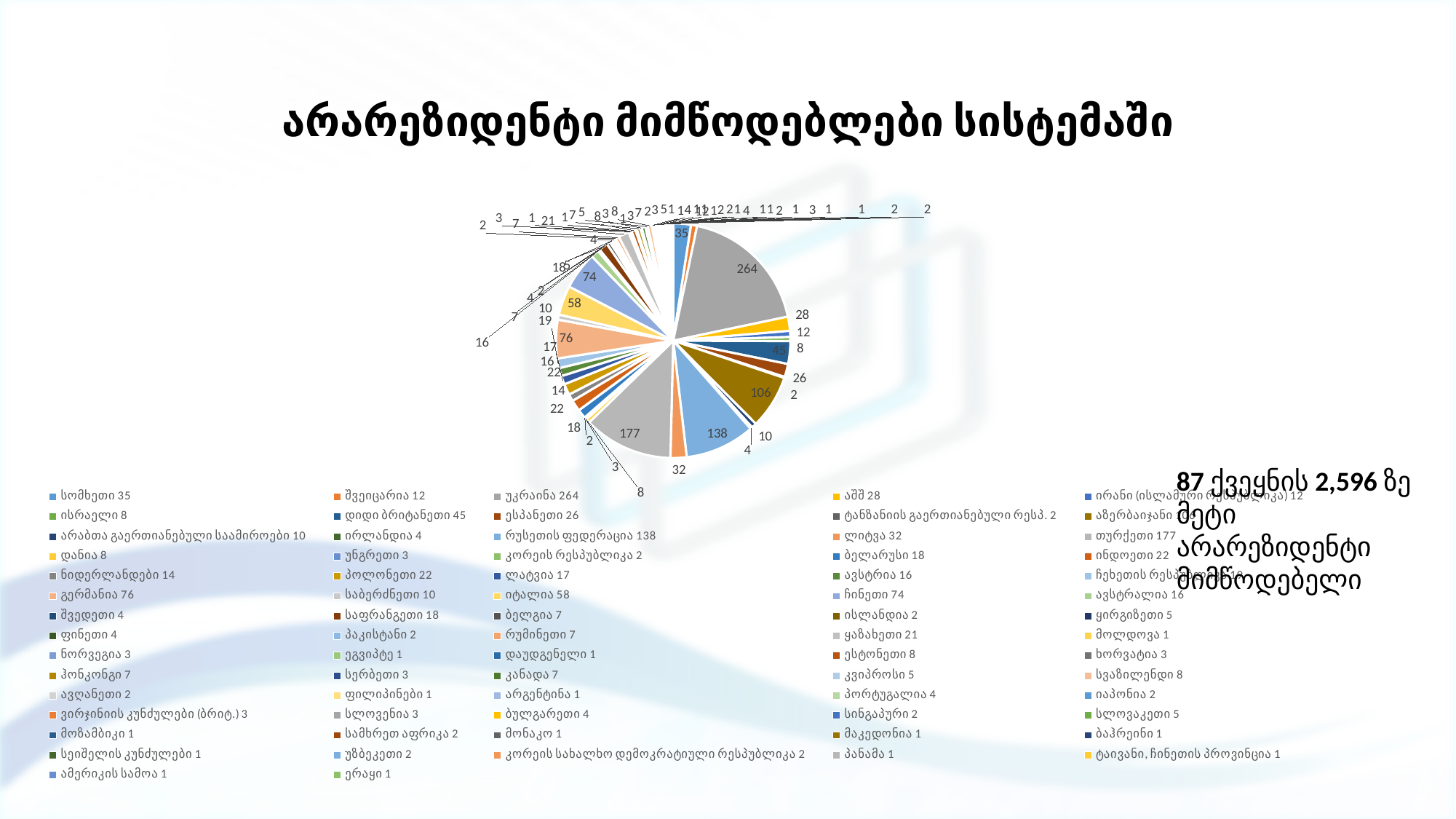
What is the title of the chart slide? არარეზიდენტი მიმწოდებლები სისტემაში What is the difference between the values for უკრაინა (264) and თურქეთი (177)? 87 Which is larger, the value for რუსეთის ფედერაცია or the value for თურქეთი? თურქეთი What is the value for თურქეთი (Turkey) in the pie chart? 177 What kind of chart is shown on the slide? pie chart What is the value for გერმანია (Germany) in the pie chart? 76 Which is larger, the value for ჩინეთი (China) or the value for გერმანია (Germany)? გერმანია What is the value for რუსეთის ფედერაცია (Russian Federation) in the pie chart? 138 What is the value for იტალია (Italy) in the pie chart? 58 What is the value for უკრაინა (Ukraine) in the pie chart? 264 What is the difference between the values for დიდი ბრიტანეთი (45) and ესპანეთი (26)? 19 Which category has the largest slice in the pie chart? უკრაინა (264)